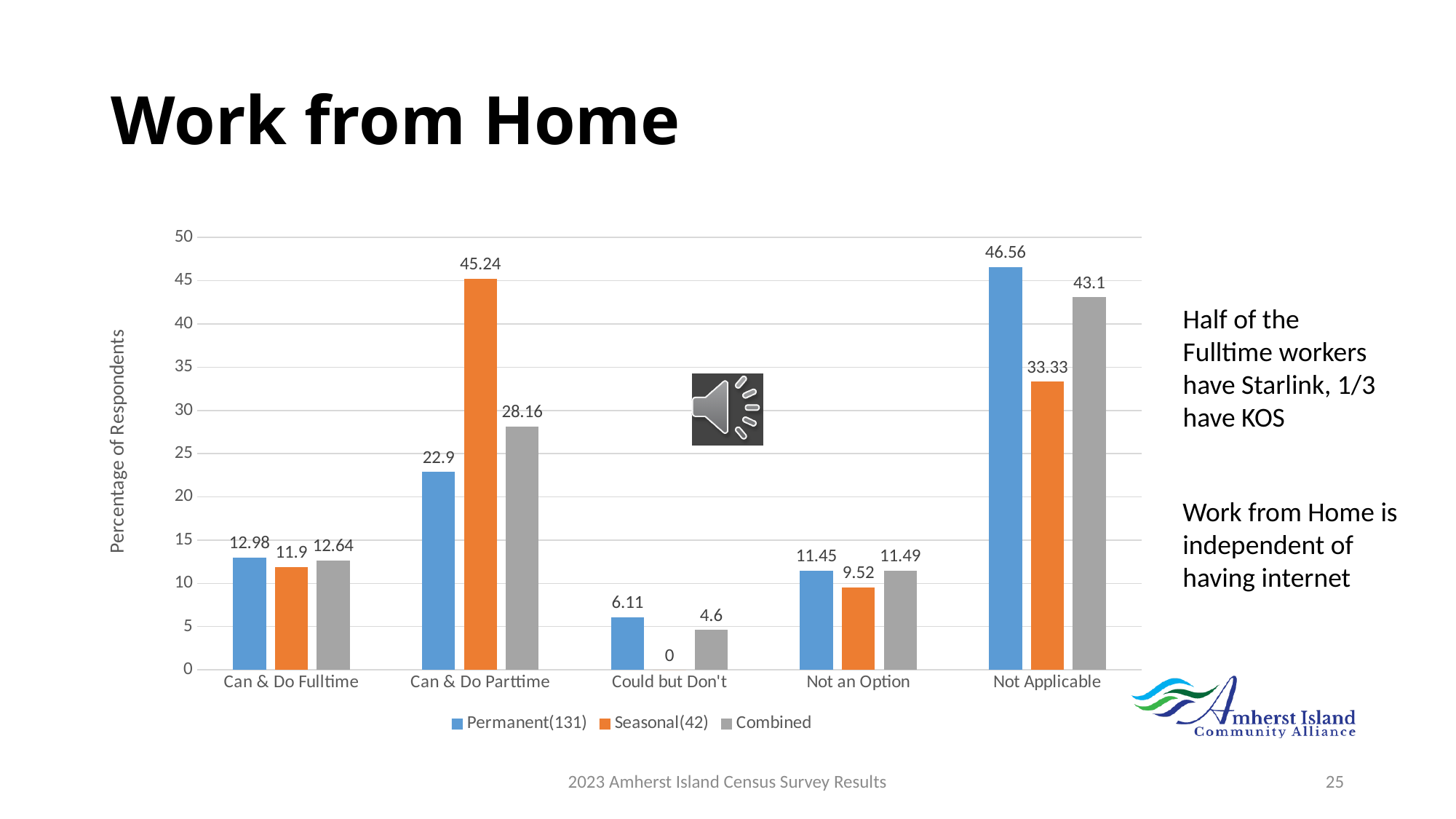
What is the Seasonal(42) value for Not Applicable? 33.33 Which is larger for Not an Option: the Permanent(131) value or the Seasonal(42) value? Permanent(131) What is the Permanent(131) value for Can & Do Parttime? 22.9 Which category has the lowest Seasonal(42) value? Could but Don't What is the label of the vertical axis? Percentage of Respondents Which category has the highest Permanent(131) value? Not Applicable How many categories are shown on the x axis? 5 What is the Combined value for Could but Don't? 4.6 Which colour represents the Seasonal(42) series? Orange What is the difference between the Seasonal(42) and Permanent(131) values for Can & Do Parttime? 22.34 How many series does the legend list? 3 What kind of chart is shown on the slide? Bar chart